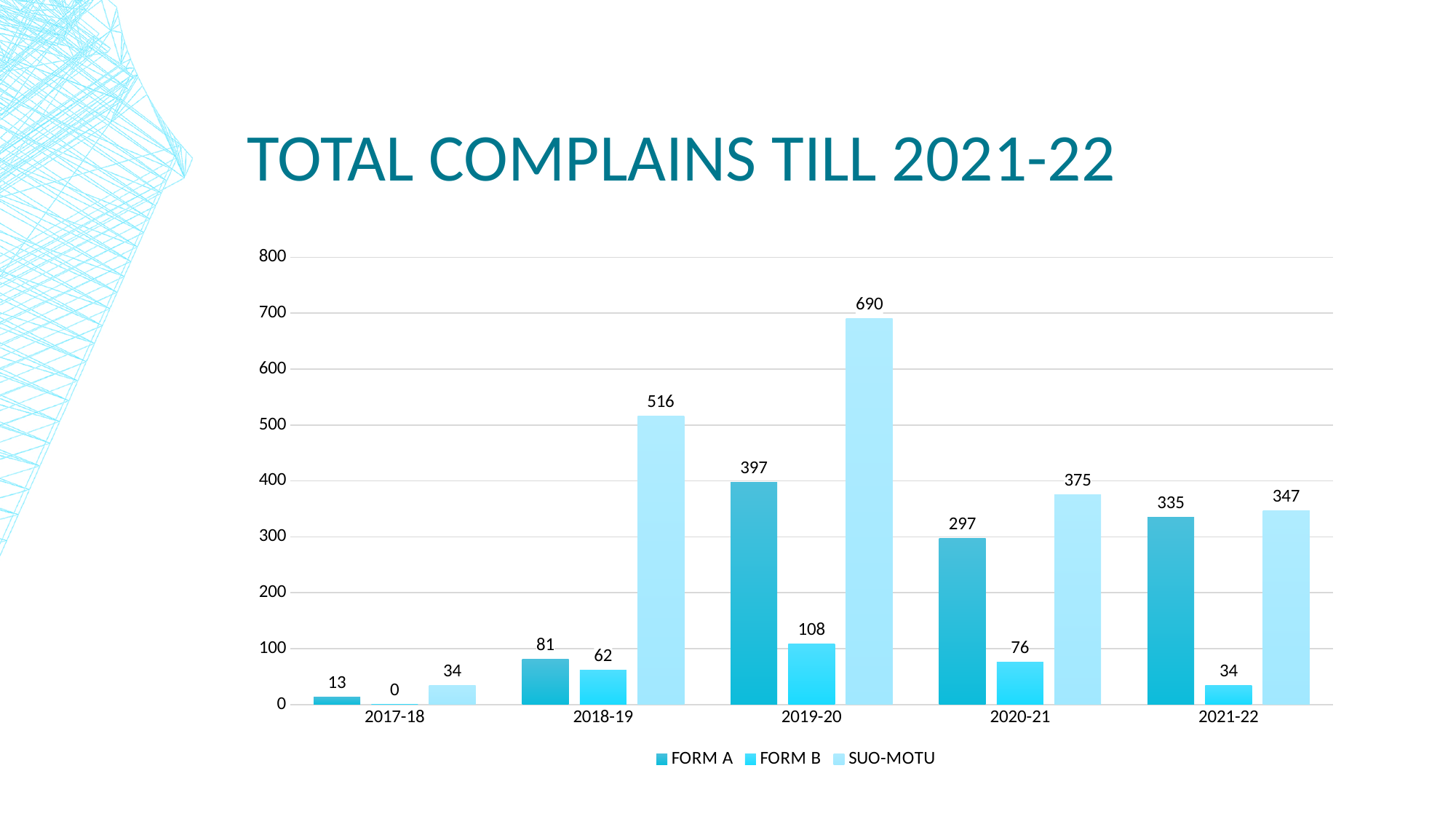
Which year has the highest SUO-MOTU value? 2019-20 Is the FORM A value for 2019-20 greater or less than 300? greater What kind of chart is shown on the slide? Bar chart What is the FORM B value for 2017-18? 0 How many years are shown on the x axis? 5 Which year has the lowest FORM A value? 2017-18 What is the FORM A value for 2020-21? 297 What is the difference between the SUO-MOTU value and the FORM A value in 2018-19? 435 How many series does the legend list? 3 What is the SUO-MOTU value for 2019-20? 690 Which is larger in 2021-22, FORM A or SUO-MOTU? SUO-MOTU What is the title of the chart? TOTAL COMPLAINS TILL 2021-22